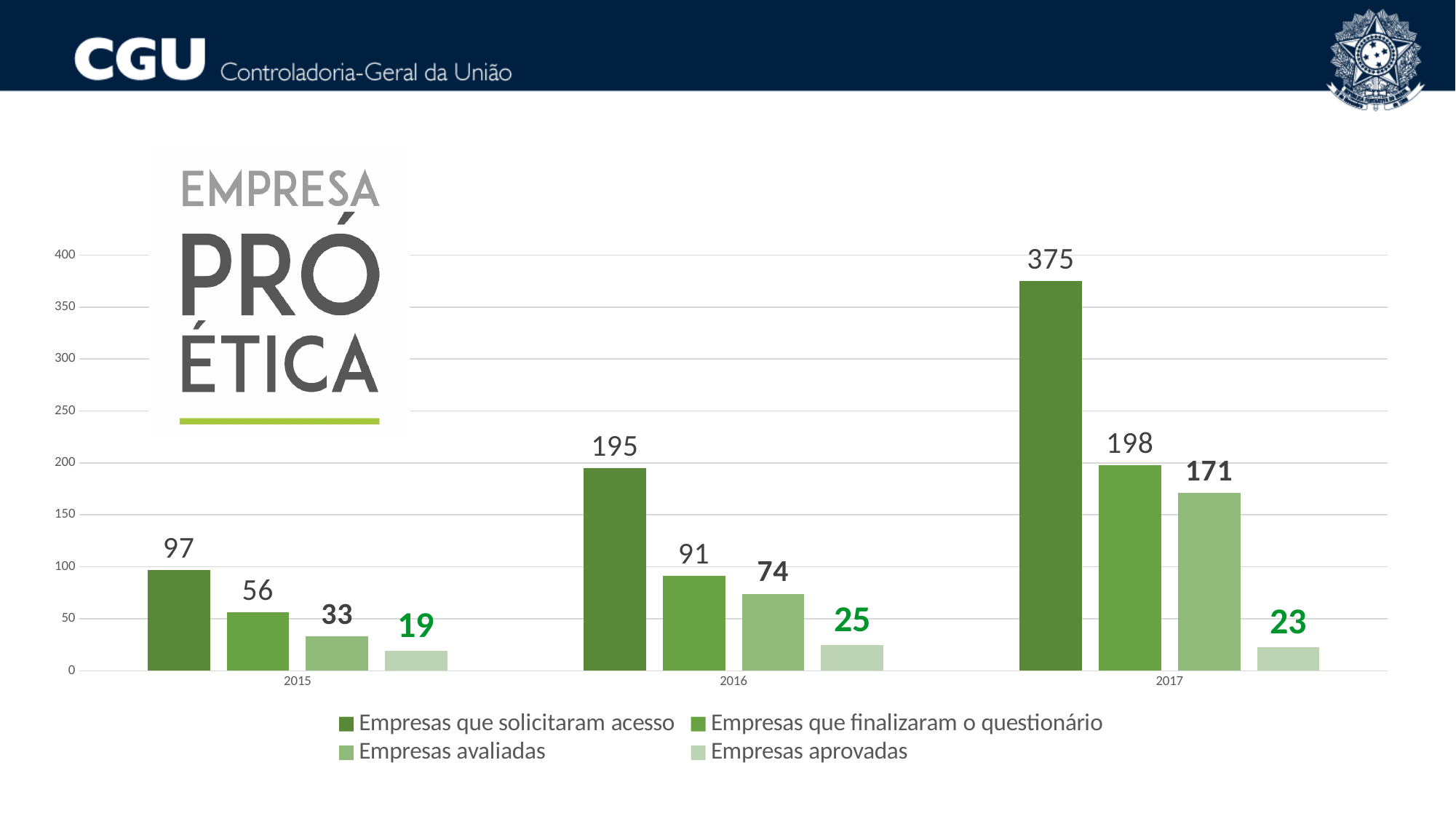
In which year was the number of Empresas que solicitaram acesso highest? 2017 What is the value for Empresas que finalizaram o questionário in 2017? 198 How many years are shown on the x axis? 3 What is the value for Empresas avaliadas in 2015? 33 What is the difference between Empresas que solicitaram acesso and Empresas que finalizaram o questionário in 2016? 104 Which is larger: Empresas avaliadas in 2017 or Empresas que finalizaram o questionário in 2016? Empresas avaliadas in 2017 In which year was the number of Empresas aprovadas lowest? 2015 What is the value for Empresas aprovadas in 2016? 25 How many series does the legend list? 4 What kind of chart is shown on the slide? Bar chart How many companies requested access (Empresas que solicitaram acesso) in 2017? 375 Does the number of Empresas que solicitaram acesso rise or fall from 2015 to 2017? Rise